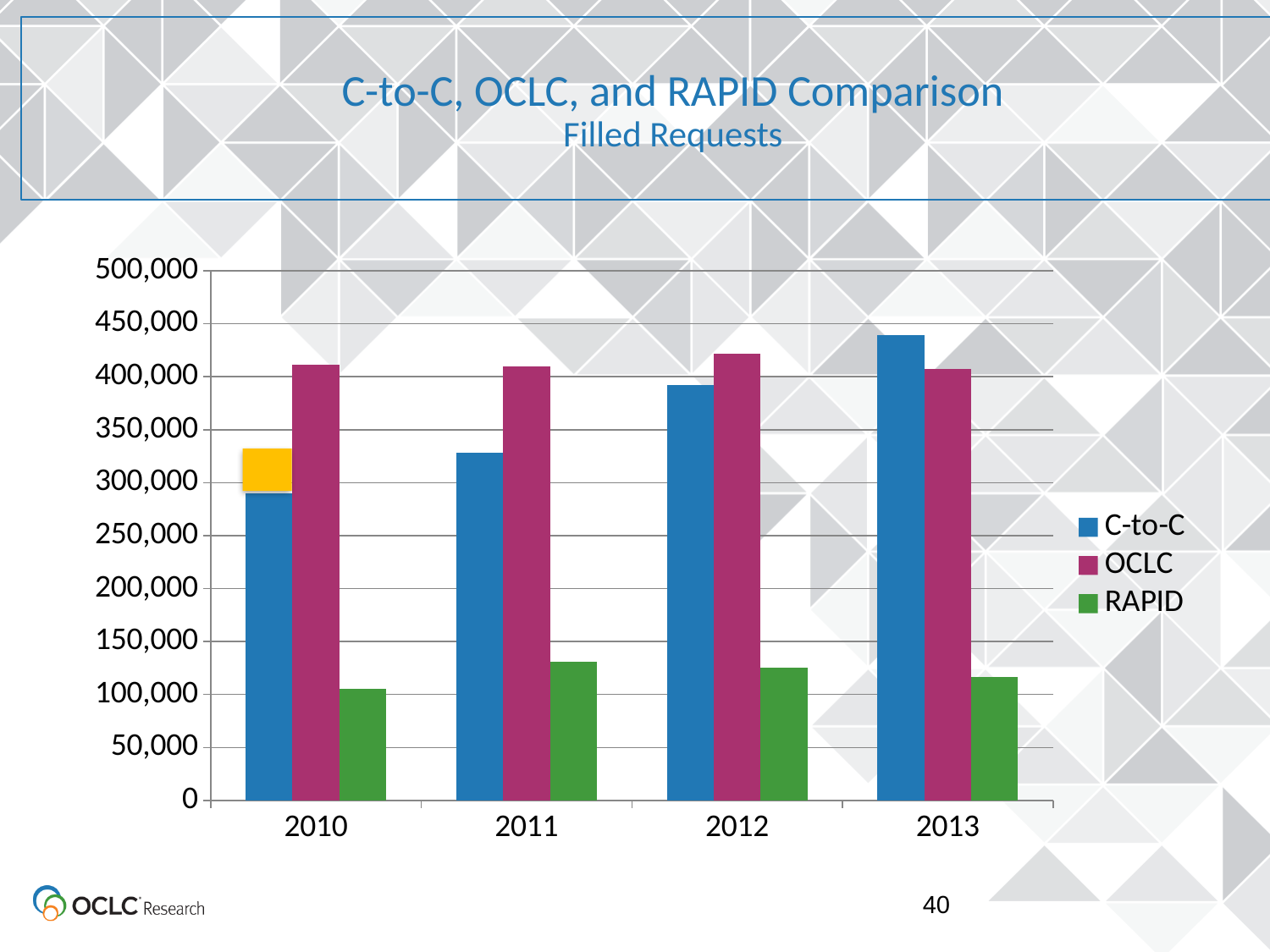
In 2013, which is larger, C-to-C or OCLC? C-to-C Do the C-to-C values rise or fall from 2010 to 2013? rise What is the subtitle of the chart below the main title? Filled Requests In 2010, which is larger, C-to-C or OCLC? OCLC What kind of chart is shown on the slide? bar chart How many series does the legend list? 3 In which year is the C-to-C bar highest? 2013 In which year is the RAPID bar lowest? 2010 Is the value for RAPID in 2011 greater or less than 100,000? greater Is the value for C-to-C in 2011 greater or less than 350,000? less How many years are shown on the x axis? 4 Is the value for OCLC in 2010 greater or less than 400,000? greater